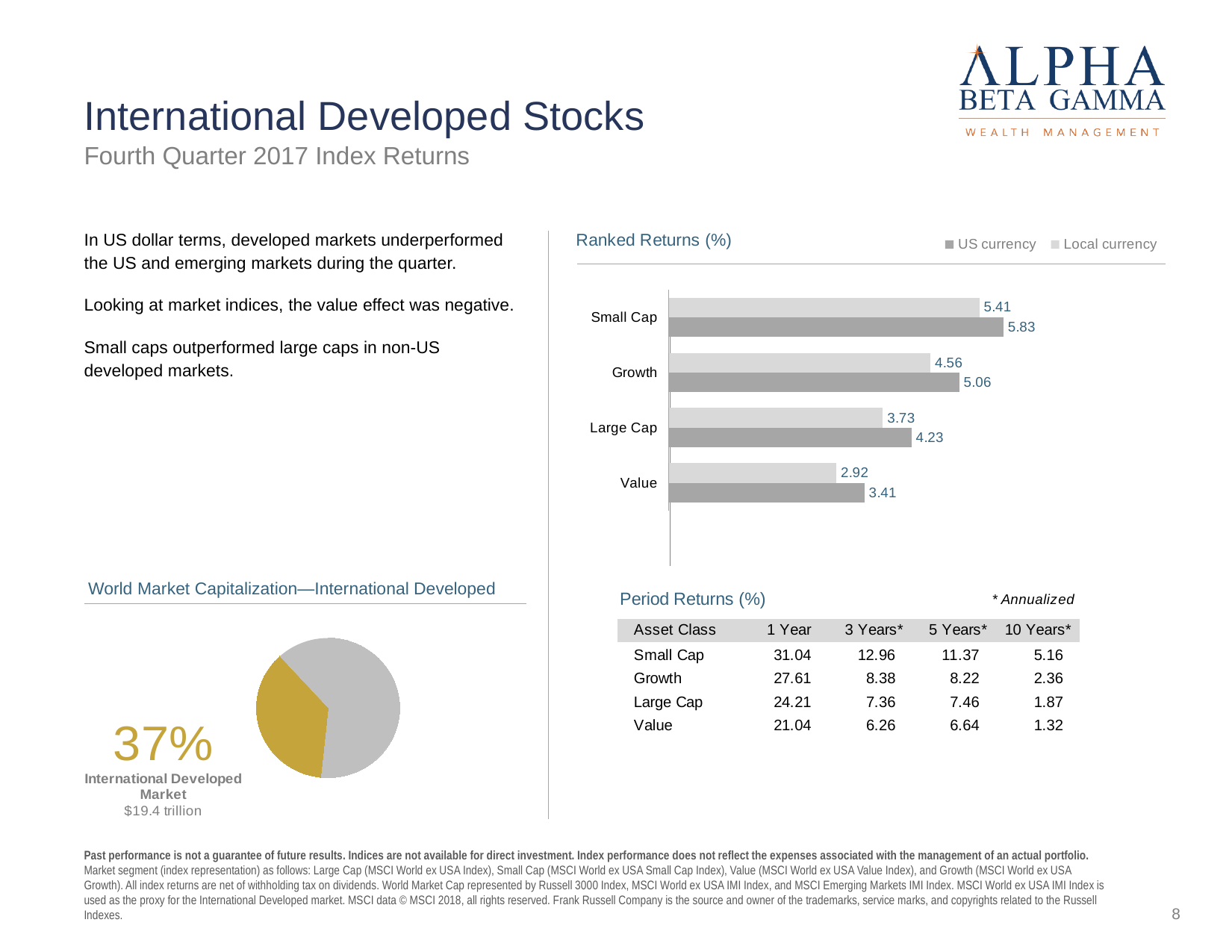
How many series does the legend of the Ranked Returns (%) chart list? 2 In the Ranked Returns (%) chart, what is the Local currency return for Growth? 4.56 In the Ranked Returns (%) chart, which category has the lowest Local currency return? Value What type of chart is the World Market Capitalization—International Developed chart? Pie chart In the Ranked Returns (%) chart, which is larger for Growth: the US currency return or the Local currency return? US currency In the World Market Capitalization—International Developed pie chart, what share is labelled for the International Developed Market? 37% In the Ranked Returns (%) chart, what is the Local currency return for Value? 2.92 How many categories are shown in the Ranked Returns (%) chart? 4 In the Ranked Returns (%) chart, what is the US currency return for Small Cap? 5.83 In the Ranked Returns (%) chart, what is the difference between the US currency and Local currency returns for Large Cap? 0.50 In the Ranked Returns (%) chart, which category has the highest US currency return? Small Cap What type of chart is the Ranked Returns (%) chart? Bar chart